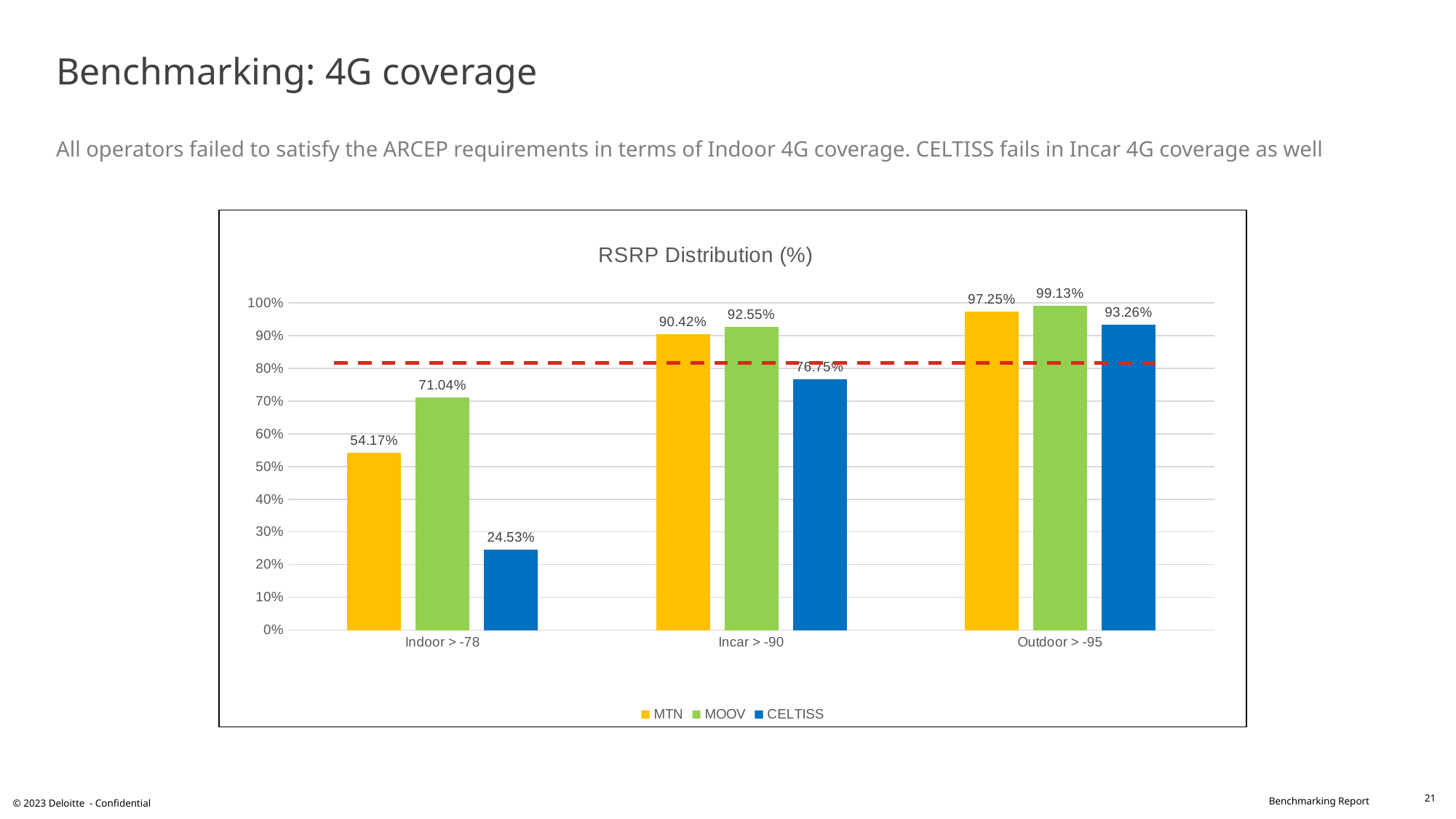
How many series does the legend list? 3 How many categories are shown on the x axis? 3 What is the value for MTN in the Indoor > -78 category? 54.17% Which is larger in the Incar > -90 category: MTN or CELTISS? MTN Which operator has the highest value in the Outdoor > -95 category? MOOV What is the value for MOOV in the Outdoor > -95 category? 99.13% Which operator has the lowest value in the Indoor > -78 category? CELTISS Is the value for CELTISS in the Indoor > -78 category greater or less than 30%? less What is the difference between MOOV and MTN in the Indoor > -78 category? 16.87% What kind of chart is shown on the slide? Bar chart What is the title of the chart? RSRP Distribution (%) What is the value for CELTISS in the Incar > -90 category? 76.75%